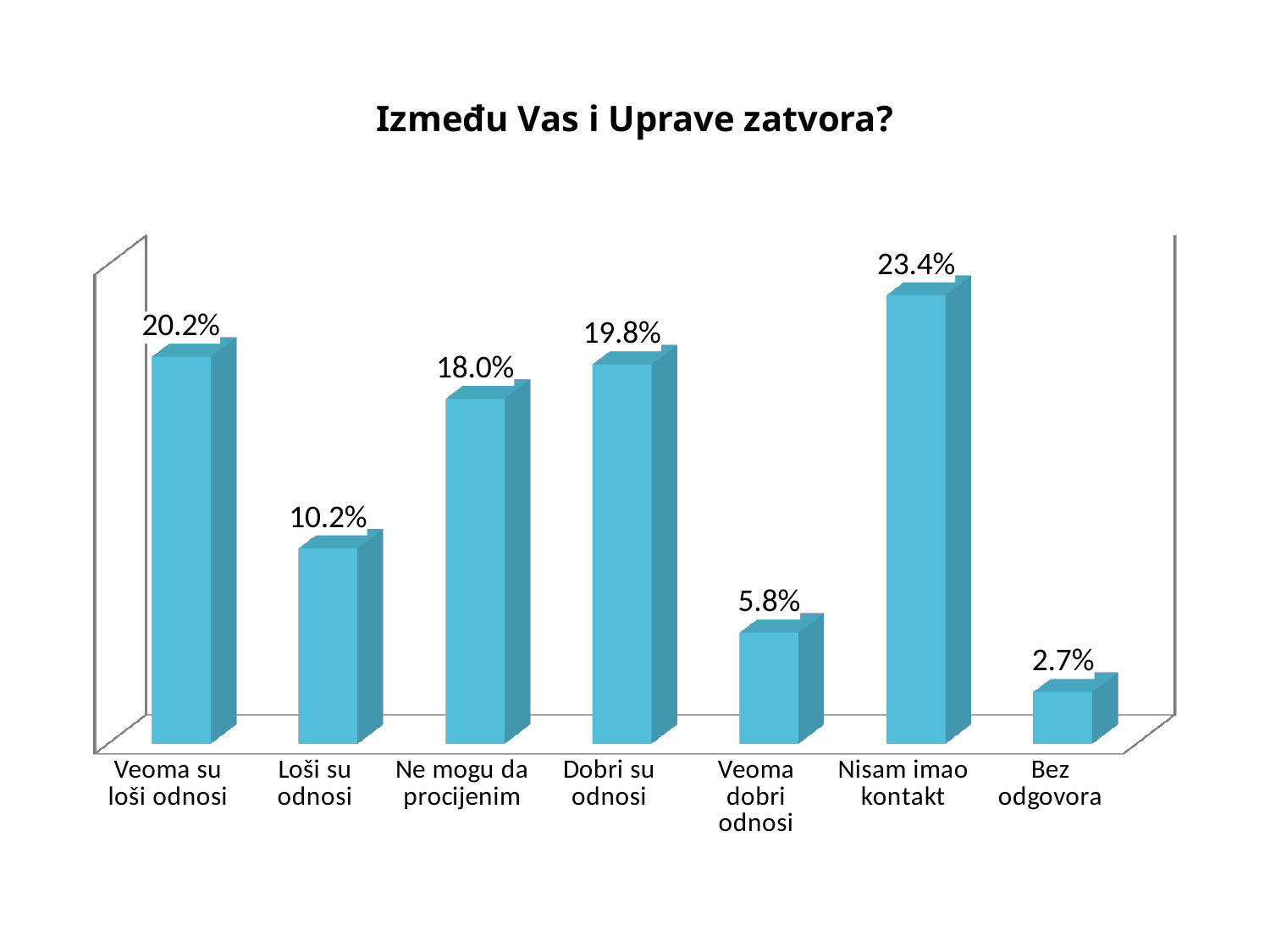
How many categories are shown on the x axis? 7 What kind of chart is shown on the slide? Bar chart Which category has the highest value? Nisam imao kontakt What is the value for "Nisam imao kontakt"? 23.4% Which is larger, the value for "Dobri su odnosi" or the value for "Loši su odnosi"? Dobri su odnosi What is the value for "Veoma dobri odnosi"? 5.8% What is the title of the chart? Između Vas i Uprave zatvora? Which is larger, the value for "Ne mogu da procijenim" or the value for "Veoma dobri odnosi"? Ne mogu da procijenim What is the difference between the values for "Veoma su loši odnosi" and "Loši su odnosi"? 10.0% Which category has the lowest value? Bez odgovora What is the value for "Loši su odnosi"? 10.2% What is the difference between the values for "Nisam imao kontakt" and "Bez odgovora"? 20.7%